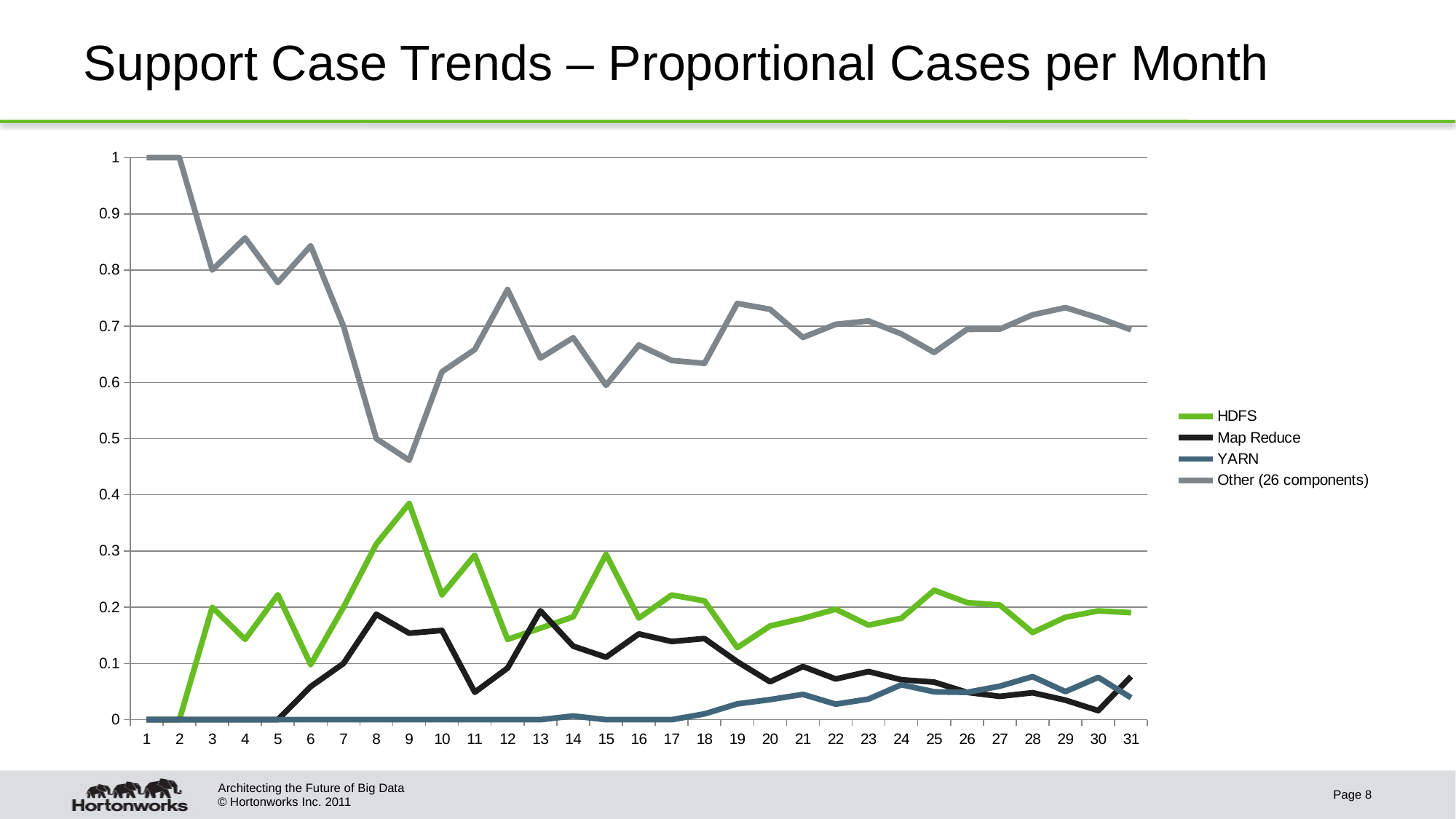
At which month does the Other (26 components) series reach its lowest value? 9 What kind of chart is shown on the slide? line chart How many points are plotted along the x axis for each series? 31 Does the Other (26 components) series rise or fall from month 1 to month 9? fall Is the value for Other (26 components) at month 9 greater or less than 0.5? less At which month does the HDFS series reach its highest value? 9 What is the value of the Other (26 components) series at month 1? 1 Which legend entry is described as covering 26 components? Other (26 components) How many series does the legend list? 4 What is the value of the HDFS series at month 2? 0 At month 13, which series has the larger value, Map Reduce or HDFS? Map Reduce Is the value for HDFS at month 9 greater or less than 0.3? greater